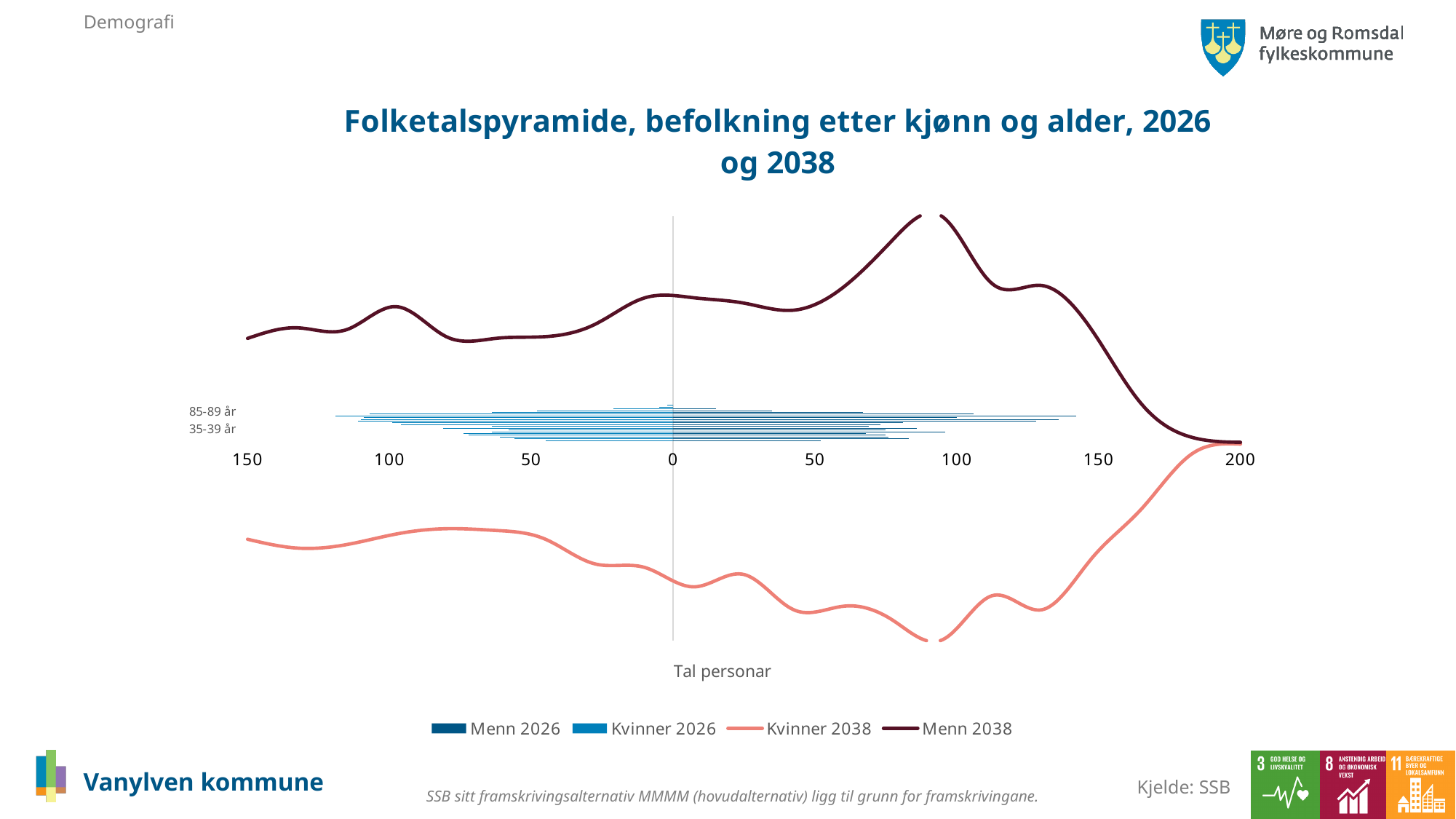
What is the label on the horizontal axis of the chart? Tal personar What is the largest value shown on the horizontal axis of the chart? 200 How many series does the chart legend list? 4 Which series in the legend are drawn as lines rather than bars? Kvinner 2038 and Menn 2038 What is the title of the chart? Folketalspyramide, befolkning etter kjønn og alder, 2026 og 2038